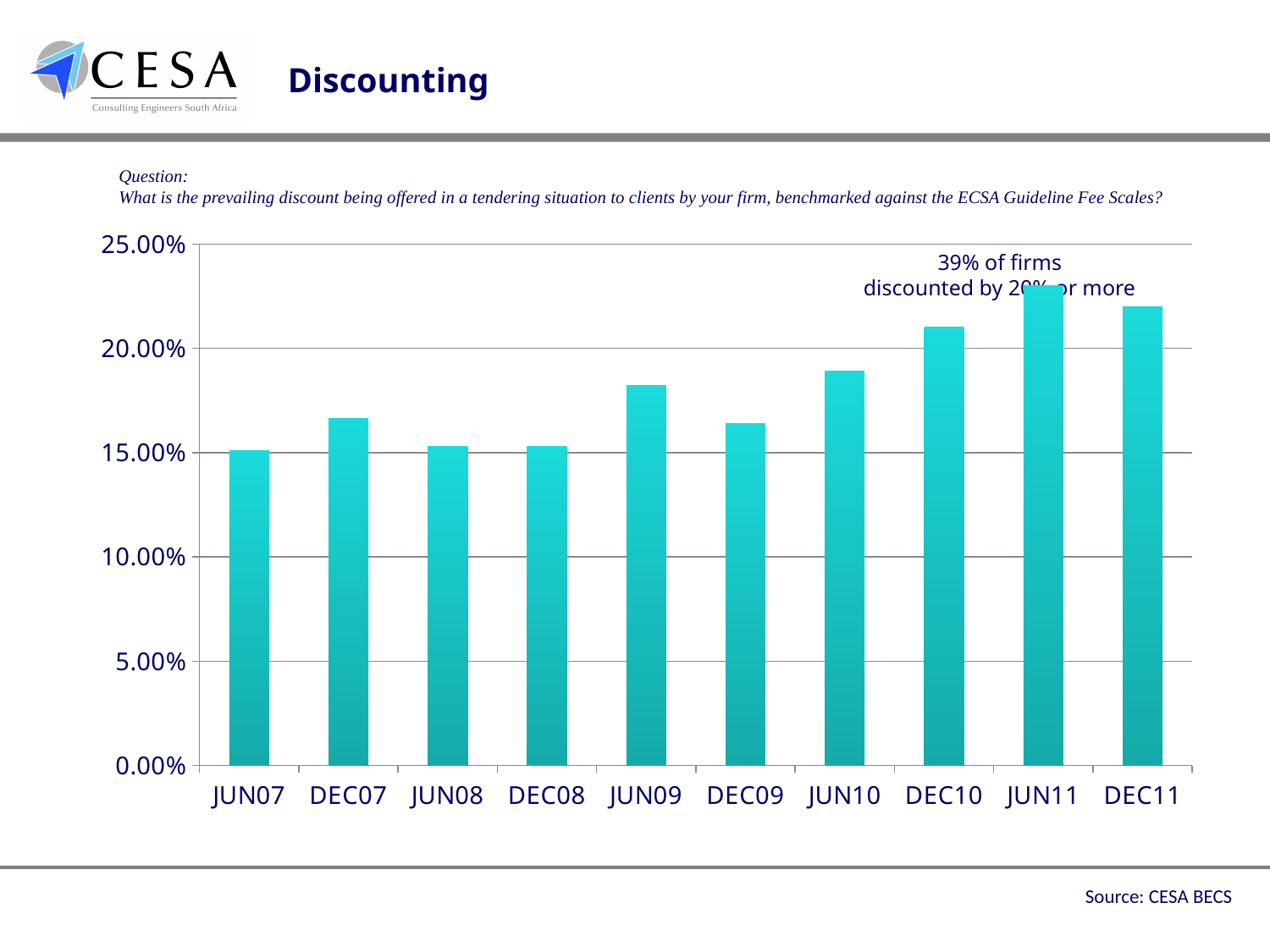
Is the value for DEC07 greater or less than 15.00%? greater According to the annotation on the chart, what percentage of firms discounted by 20% or more? 39% Is the value for JUN09 greater or less than 20.00%? less Is the value for JUN11 greater or less than 20.00%? greater Which is larger, the value for JUN09 or the value for DEC09? JUN09 How many periods are shown on the x axis of the chart? 10 Which is larger, the value for JUN10 or the value for DEC10? DEC10 What kind of chart is shown on the slide? bar chart Do the discount values generally rise or fall from JUN07 to DEC11? rise Which period has the highest discount value in the chart? JUN11